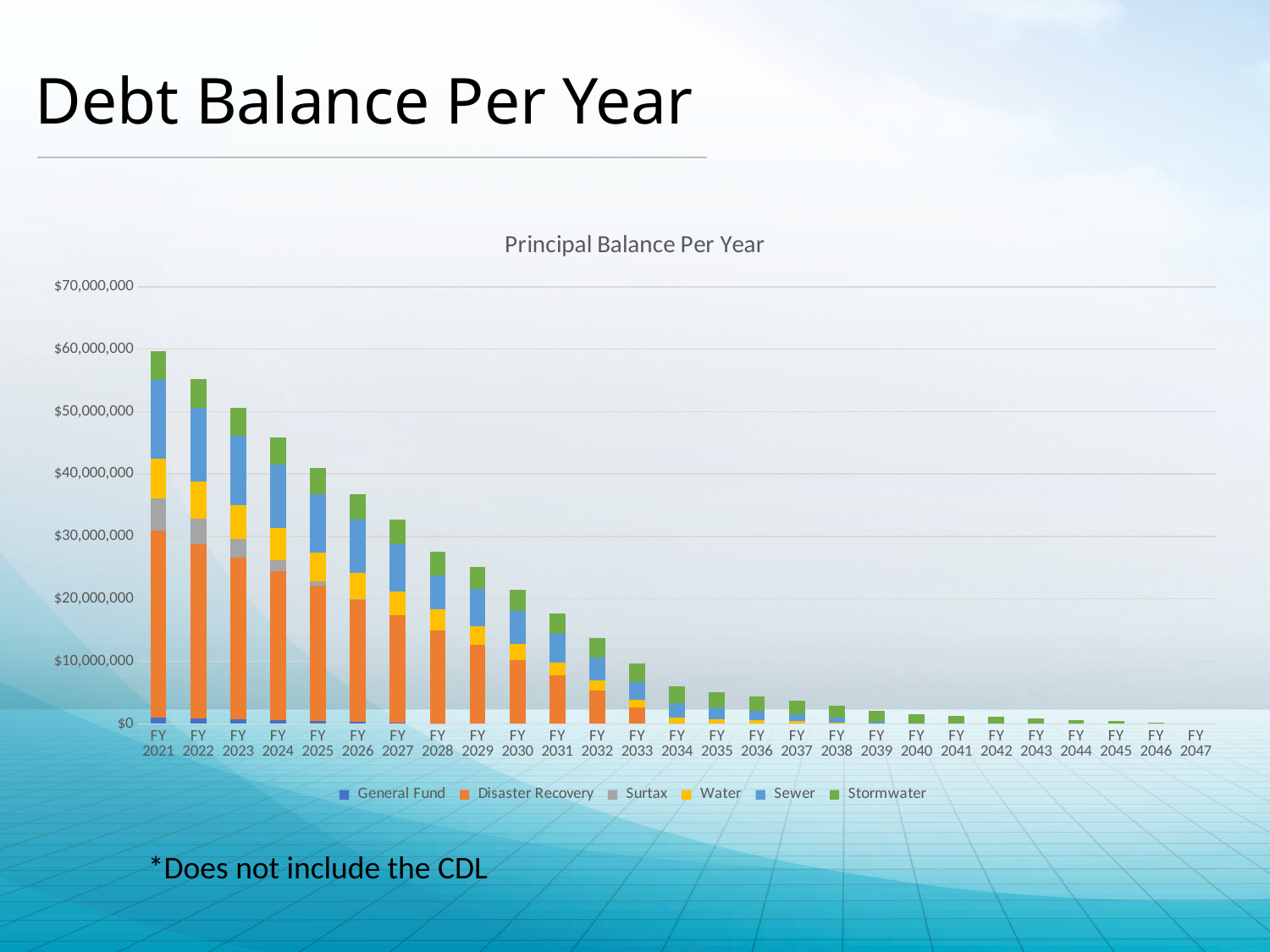
Which fiscal year has the lowest total principal balance? FY 2047 How many series does the legend list? 6 Is the total principal balance for FY 2030 greater or less than $30,000,000? less Is the total principal balance for FY 2026 greater or less than $40,000,000? less How many fiscal years are shown on the x axis? 27 What is the title of the chart? Principal Balance Per Year Is the total principal balance for FY 2021 greater or less than $50,000,000? greater Which fiscal year has the highest total principal balance? FY 2021 Do the total principal balances rise or fall from FY 2021 to FY 2047? fall What type of chart is shown on the slide? stacked bar chart Which series is shown in orange in the legend? Disaster Recovery Which has a larger total principal balance, FY 2022 or FY 2028? FY 2022